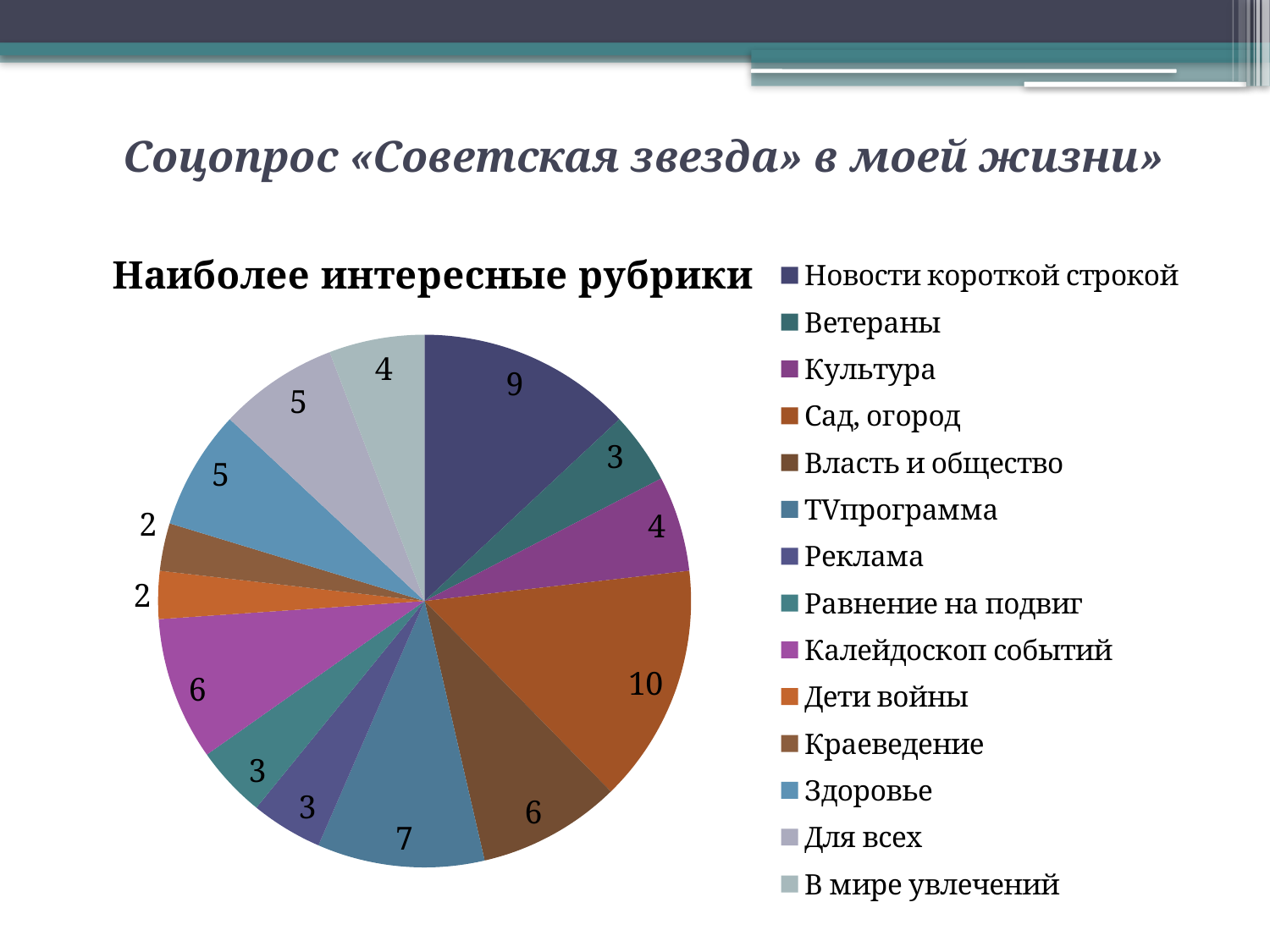
Which is larger, the value for Культура or the value for Калейдоскоп событий? Калейдоскоп событий What is the difference between the values for TVпрограмма and Ветераны? 4 What kind of chart is shown on the slide? pie chart How many categories does the legend of the pie chart list? 14 What is the value for Здоровье? 5 What is the value for Новости короткой строкой? 9 What is the difference between the values for Сад, огород and Новости короткой строкой? 1 What is the title of the chart? Наиболее интересные рубрики What is the value for Сад, огород? 10 What is the value for В мире увлечений? 4 What is the value for TVпрограмма? 7 Which category has the largest slice of the pie? Сад, огород